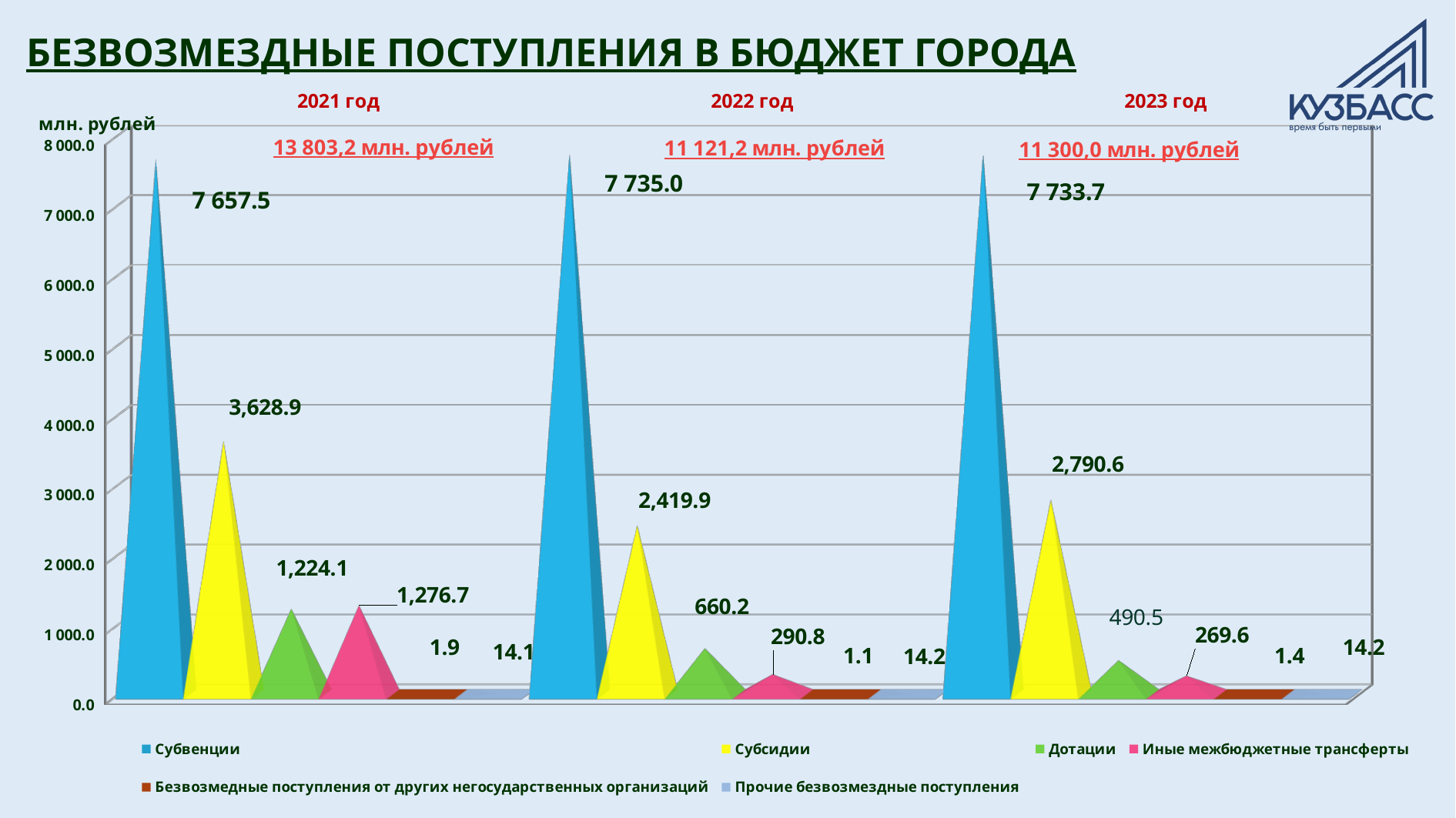
What is the difference between the Субсидии values for 2021 год and 2022 год? 1,209.0 How many year groups are shown on the x axis? 3 Which series has the lowest value in 2021 год? Безвозмедные поступления от других негосударственных организаций What is the value for Субвенции in 2021 год? 7 657.5 What is the total shown for 2023 год? 11 300,0 млн. рублей Which is larger: Дотации in 2021 год or Иные межбюджетные трансферты in 2021 год? Иные межбюджетные трансферты Which series has the highest value in 2022 год? Субвенции What is the value for Субсидии in 2023 год? 2,790.6 What is the value for Прочие безвозмездные поступления in 2023 год? 14.2 What is the value for Дотации in 2022 год? 660.2 How many series does the legend list? 6 What is the value for Иные межбюджетные трансферты in 2021 год? 1,276.7